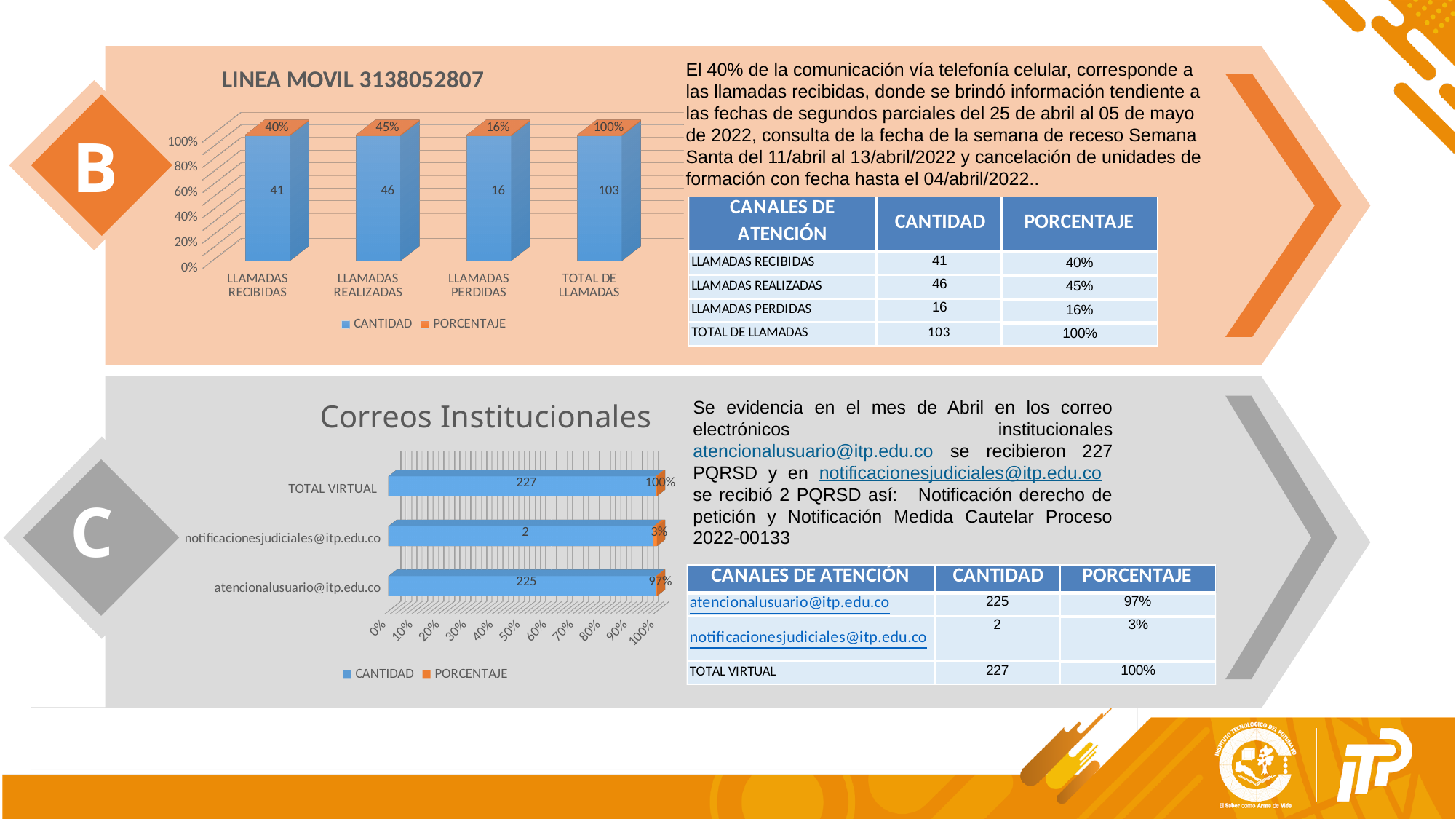
In the 'LINEA MOVIL 3138052807' chart, how many categories are shown on the x axis? 4 What type of chart is 'LINEA MOVIL 3138052807'? Bar chart In the 'Correos Institucionales' chart, which category has the highest CANTIDAD value? TOTAL VIRTUAL In the 'LINEA MOVIL 3138052807' chart, what PORCENTAJE is shown for LLAMADAS PERDIDAS? 16% In the 'LINEA MOVIL 3138052807' chart, how many series does the legend list? 2 In the 'Correos Institucionales' chart, which has a larger CANTIDAD value: atencionalusuario@itp.edu.co or notificacionesjudiciales@itp.edu.co? atencionalusuario@itp.edu.co In the 'LINEA MOVIL 3138052807' chart, what is the CANTIDAD value for LLAMADAS REALIZADAS? 46 In the 'Correos Institucionales' chart, what PORCENTAJE is shown for notificacionesjudiciales@itp.edu.co? 3% In the 'LINEA MOVIL 3138052807' chart, what is the difference between the CANTIDAD values for LLAMADAS REALIZADAS and LLAMADAS RECIBIDAS? 5 In the 'Correos Institucionales' chart, what is the CANTIDAD value for atencionalusuario@itp.edu.co? 225 In the 'Correos Institucionales' chart, what colour represents the PORCENTAJE series in the legend? Orange In the 'LINEA MOVIL 3138052807' chart, which category has the lowest CANTIDAD value? LLAMADAS PERDIDAS